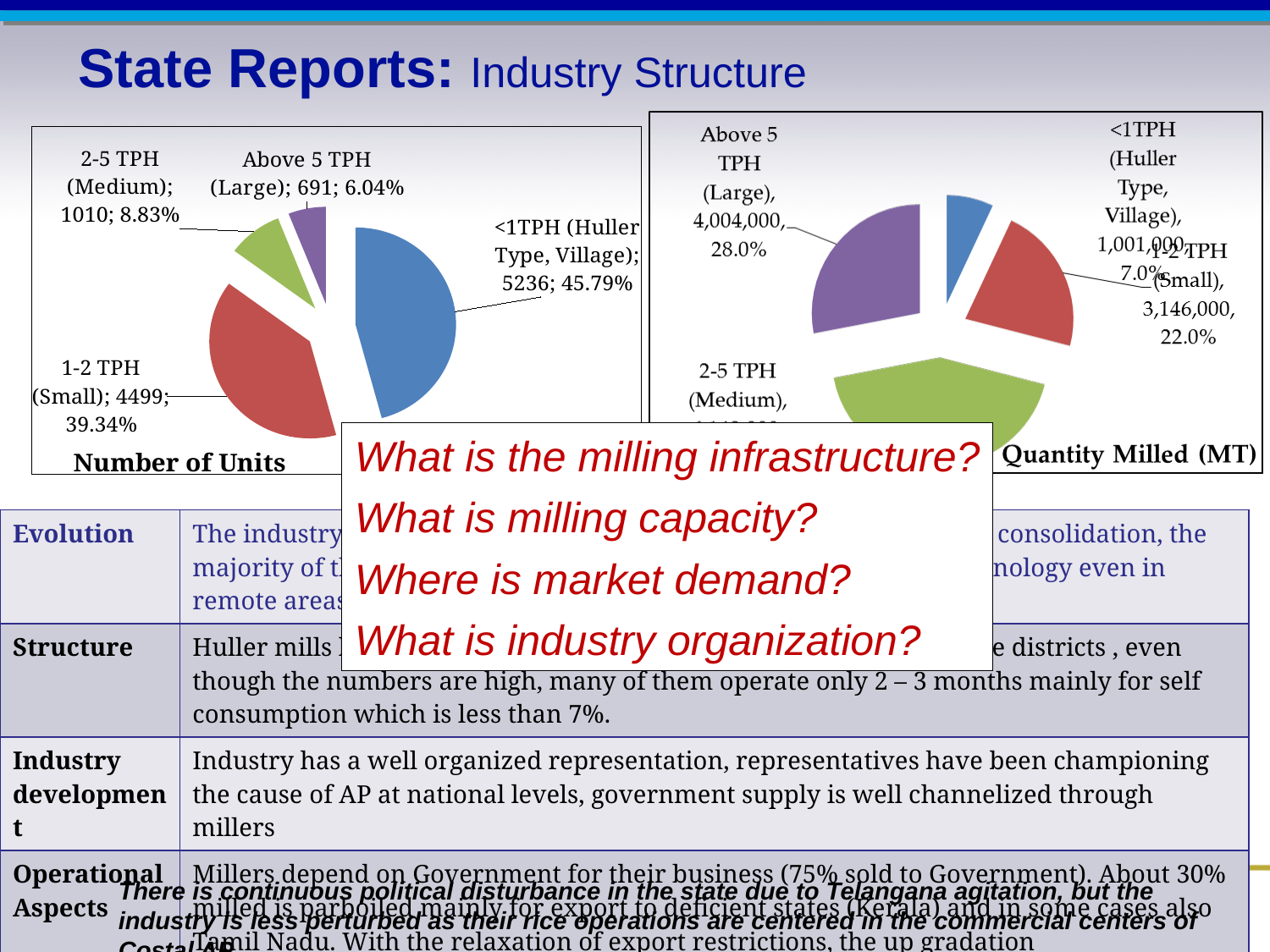
In the Quantity Milled (MT) chart, what percentage share does <1TPH (Huller Type, Village) have? 7.0% In the Number of Units chart, how many units are in the <1TPH (Huller Type, Village) category? 5236 In the Number of Units chart, which category has the largest number of units? <1TPH (Huller Type, Village) In the Quantity Milled (MT) chart, what is the difference between the quantity milled by Above 5 TPH (Large) and 1-2 TPH (Small)? 858,000 In the Quantity Milled (MT) chart, which is larger: the quantity milled by Above 5 TPH (Large) or by 1-2 TPH (Small)? Above 5 TPH (Large) In the Number of Units chart, which category has the smallest number of units? Above 5 TPH (Large) In the Quantity Milled (MT) chart, what quantity is milled by Above 5 TPH (Large) mills? 4,004,000 In the Number of Units chart, how many categories are shown? 4 In the Number of Units chart, how many units are in the Above 5 TPH (Large) category? 691 What type of chart is the Quantity Milled (MT) chart? Pie chart In the Number of Units chart, what is the difference in units between 2-5 TPH (Medium) and Above 5 TPH (Large)? 319 In the Number of Units chart, what percentage share do 1-2 TPH (Small) units have? 39.34%